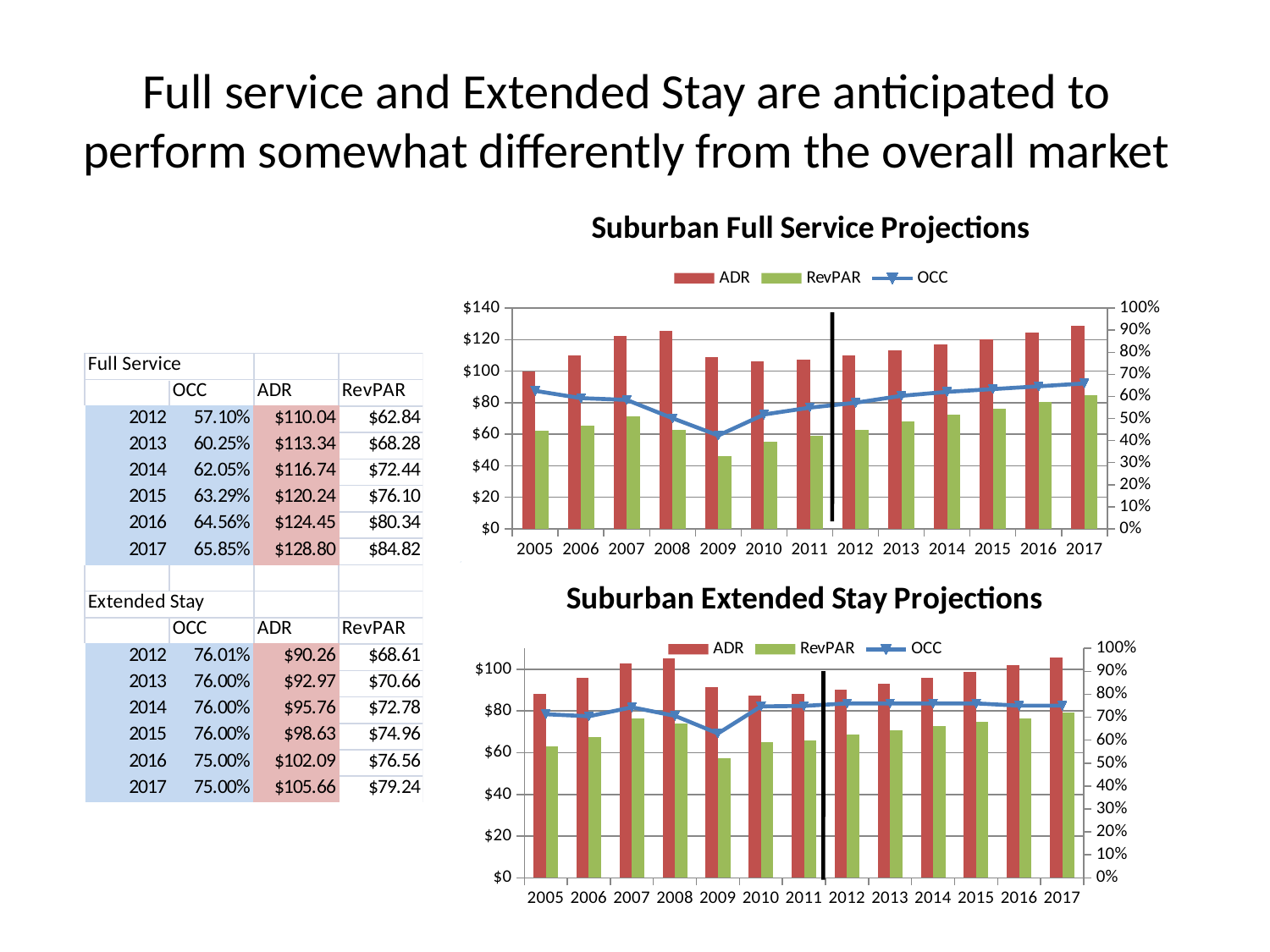
In the Suburban Extended Stay Projections chart, which is larger, the ADR bar for 2008 or the ADR bar for 2009? 2008 In the Suburban Full Service Projections chart, which year has the lowest RevPAR bar? 2009 In the Suburban Extended Stay Projections chart, which year has the lowest OCC point? 2009 In the Suburban Full Service Projections chart, is the RevPAR value for 2009 greater or less than $60? less In the Suburban Full Service Projections chart, does the OCC line rise or fall from 2012 to 2017? rises What kind of chart is the Suburban Full Service Projections chart? bar and line chart What are the three legend entries in the Suburban Extended Stay Projections chart? ADR, RevPAR, OCC How many series does the legend of the Suburban Full Service Projections chart list? 3 In the Suburban Extended Stay Projections chart, is the ADR value for 2005 greater or less than $100? less In the Suburban Full Service Projections chart, is the ADR value for 2009 greater or less than $100? greater How many years are shown on the x axis of the Suburban Extended Stay Projections chart? 13 In the Suburban Full Service Projections chart, which year has the highest ADR bar? 2017